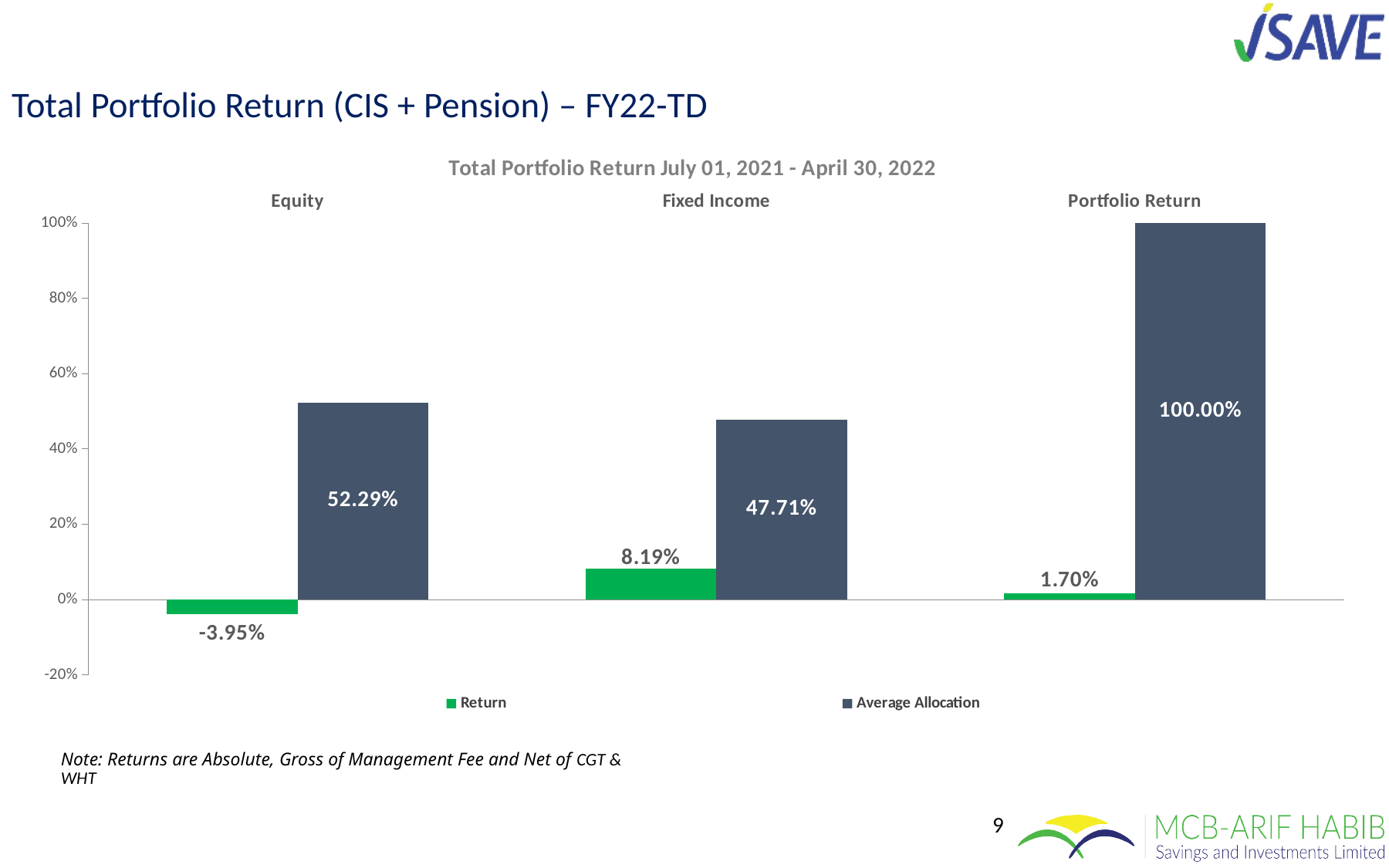
What is the title of the chart? Total Portfolio Return July 01, 2021 - April 30, 2022 What is the difference between the Average Allocation for Equity and for Fixed Income? 4.58% What is the Return value for Portfolio Return? 1.70% What kind of chart is shown on the slide? Bar chart What is the Average Allocation for Equity? 52.29% What is the Average Allocation for Fixed Income? 47.71% What is the Return value for Equity? -3.95% How many categories are shown on the x axis? 3 Which category has the lowest Return? Equity How many series does the legend list? 2 Which is larger, the Return for Fixed Income or the Return for Portfolio Return? Fixed Income Which category has the highest Return? Fixed Income